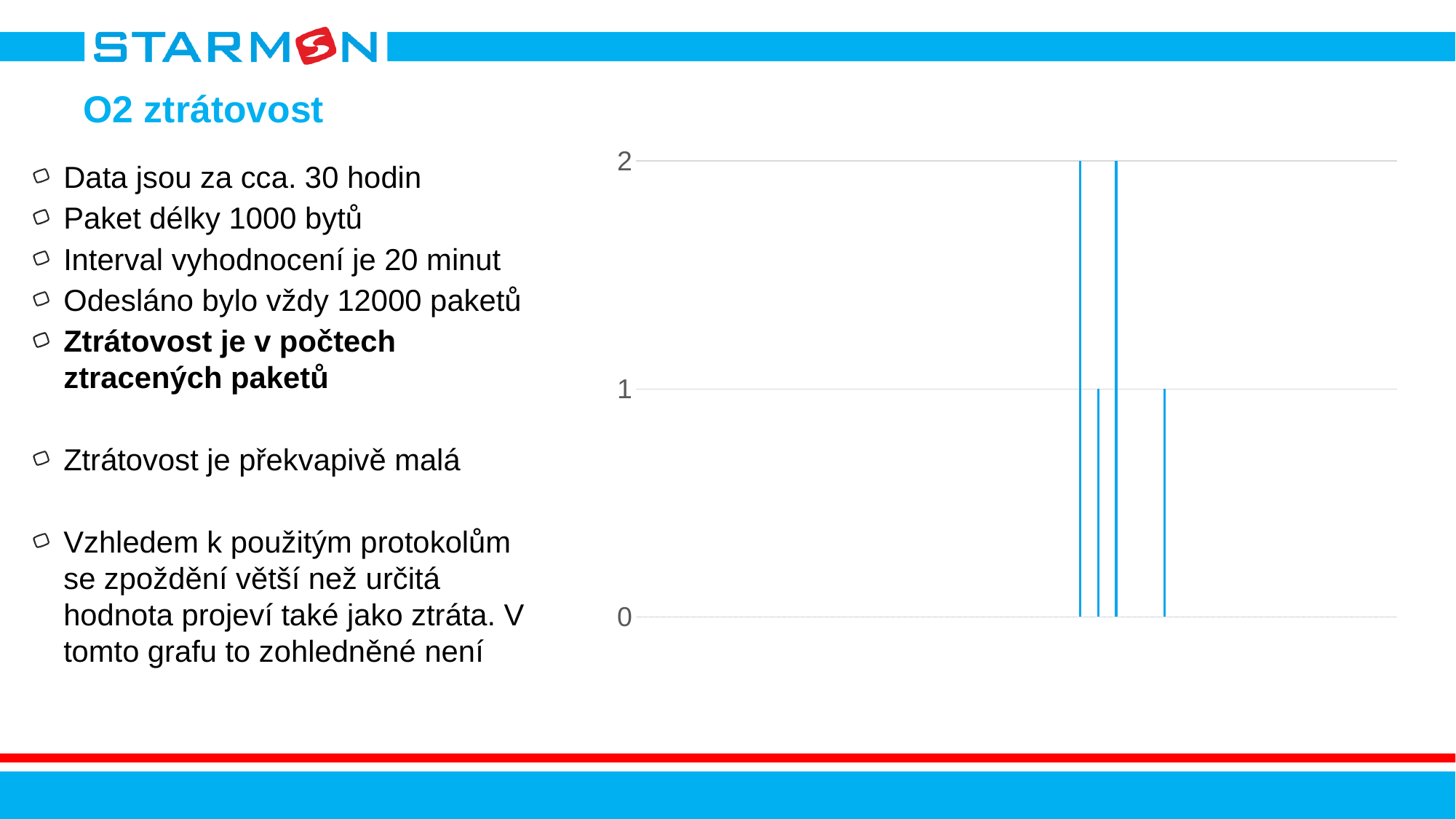
What is the highest value reached by any bar in the chart? 2 Is the first visible bar (leftmost) taller or shorter than the second visible bar? taller How many bars in the chart reach the value 1? 2 What is the difference between the tallest bar and the shortest visible bar in the chart? 1 What is the highest tick value shown on the vertical axis of the chart? 2 What is the lowest tick value shown on the vertical axis of the chart? 0 How many non-zero bars are visible in the chart? 4 What kind of chart is shown on the right side of the slide? bar chart How many bars in the chart reach the value 2? 2 Is the tallest bar in the chart greater or less than 1? greater